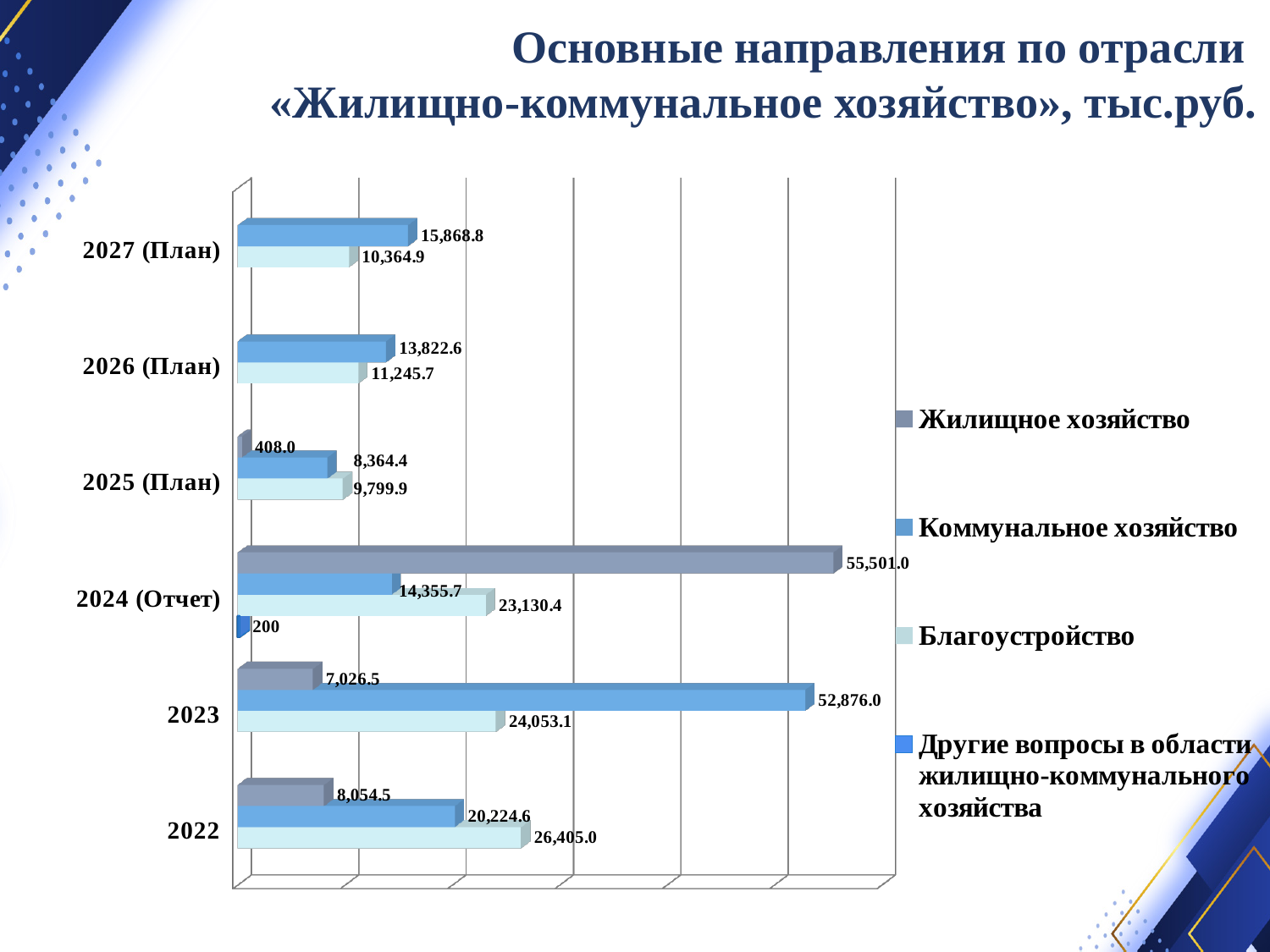
What is the value for Благоустройство in 2022? 26,405.0 How many year categories are shown on the chart? 6 What is the difference between Благоустройство in 2023 and in 2024 (Отчет)? 922.7 What kind of chart is shown on the slide? Bar chart What is the value for Коммунальное хозяйство in 2027 (План)? 15,868.8 In which year does Коммунальное хозяйство have its highest value? 2023 Does the value for Благоустройство rise or fall from 2022 to 2025 (План)? Fall How many series does the legend list? 4 In which year does Благоустройство have its lowest value? 2025 (План) What is the value for Другие вопросы в области жилищно-коммунального хозяйства in 2024 (Отчет)? 200 What is the value for Жилищное хозяйство in 2024 (Отчет)? 55,501.0 Which is larger in 2025 (План): Коммунальное хозяйство or Благоустройство? Благоустройство